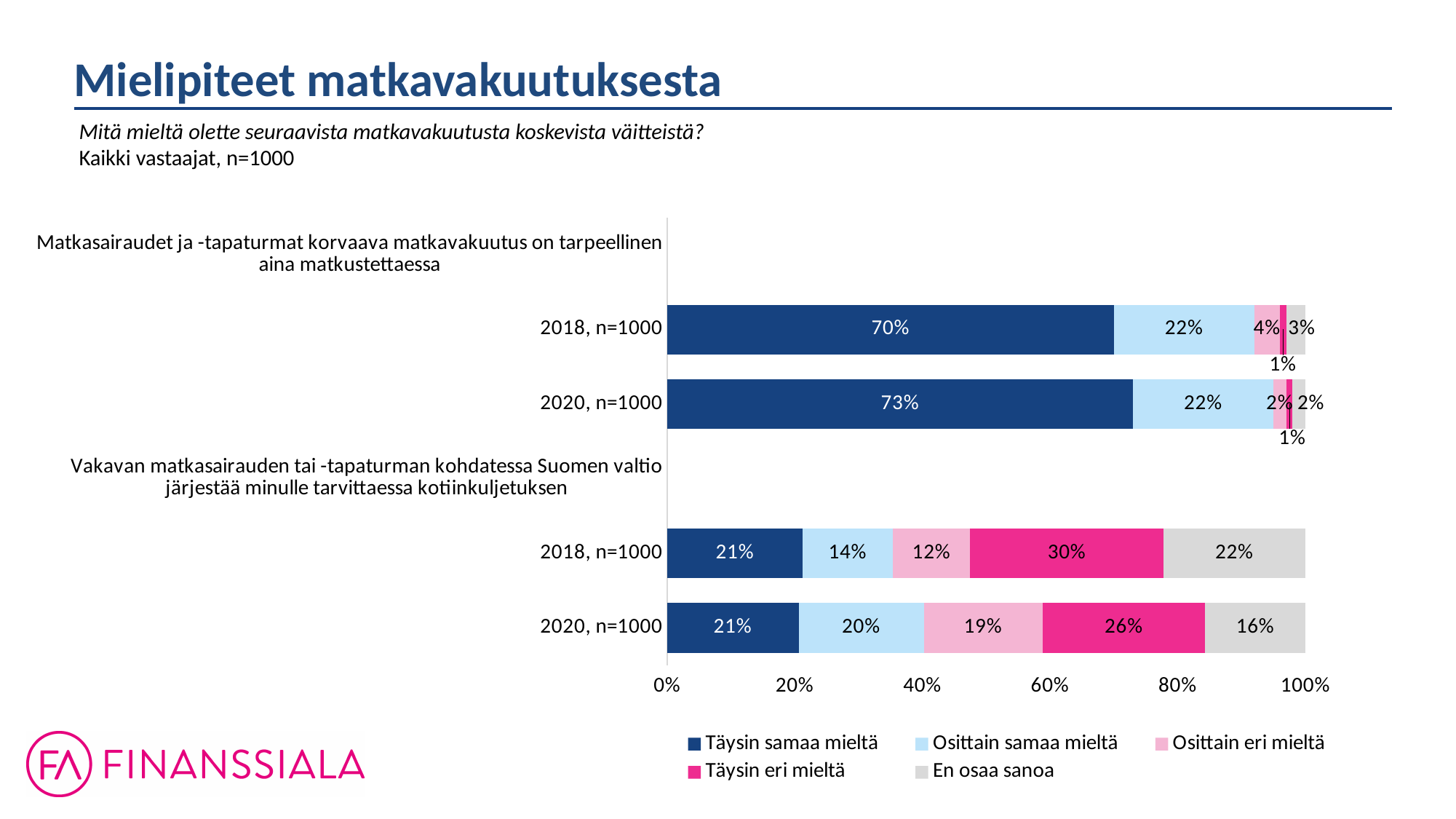
What is the combined share of 'Täysin samaa mieltä' and 'Osittain samaa mieltä' in 2020 for the statement about the Finnish state arranging repatriation? 41% For the statement that the Finnish state would arrange repatriation in case of serious travel illness or accident, what share answered 'Täysin eri mieltä' in 2018? 30% How many response categories does the legend list? 5 What share of respondents in 2020 answered 'Täysin samaa mieltä' to the statement that travel insurance covering travel illnesses and accidents is necessary whenever travelling? 73% By how many percentage points did the 'Täysin samaa mieltä' share for the statement that travel insurance is necessary whenever travelling change from 2018 to 2020? 3 percentage points What share answered 'En osaa sanoa' in 2020 for the statement about the Finnish state arranging repatriation? 16% How many bars are plotted in the chart? 4 For the statement about the Finnish state arranging repatriation, which year had the larger 'Osittain samaa mieltä' share, 2018 or 2020? 2020 What is the difference in the 'En osaa sanoa' share between 2018 and 2020 for the statement about the Finnish state arranging repatriation? 6 percentage points What type of chart is shown on the slide? Stacked bar chart In the 2018 bar for the statement about the Finnish state arranging repatriation, which response category has the largest share? Täysin eri mieltä What share answered 'Osittain eri mieltä' in 2018 for the statement that travel insurance is necessary whenever travelling? 4%